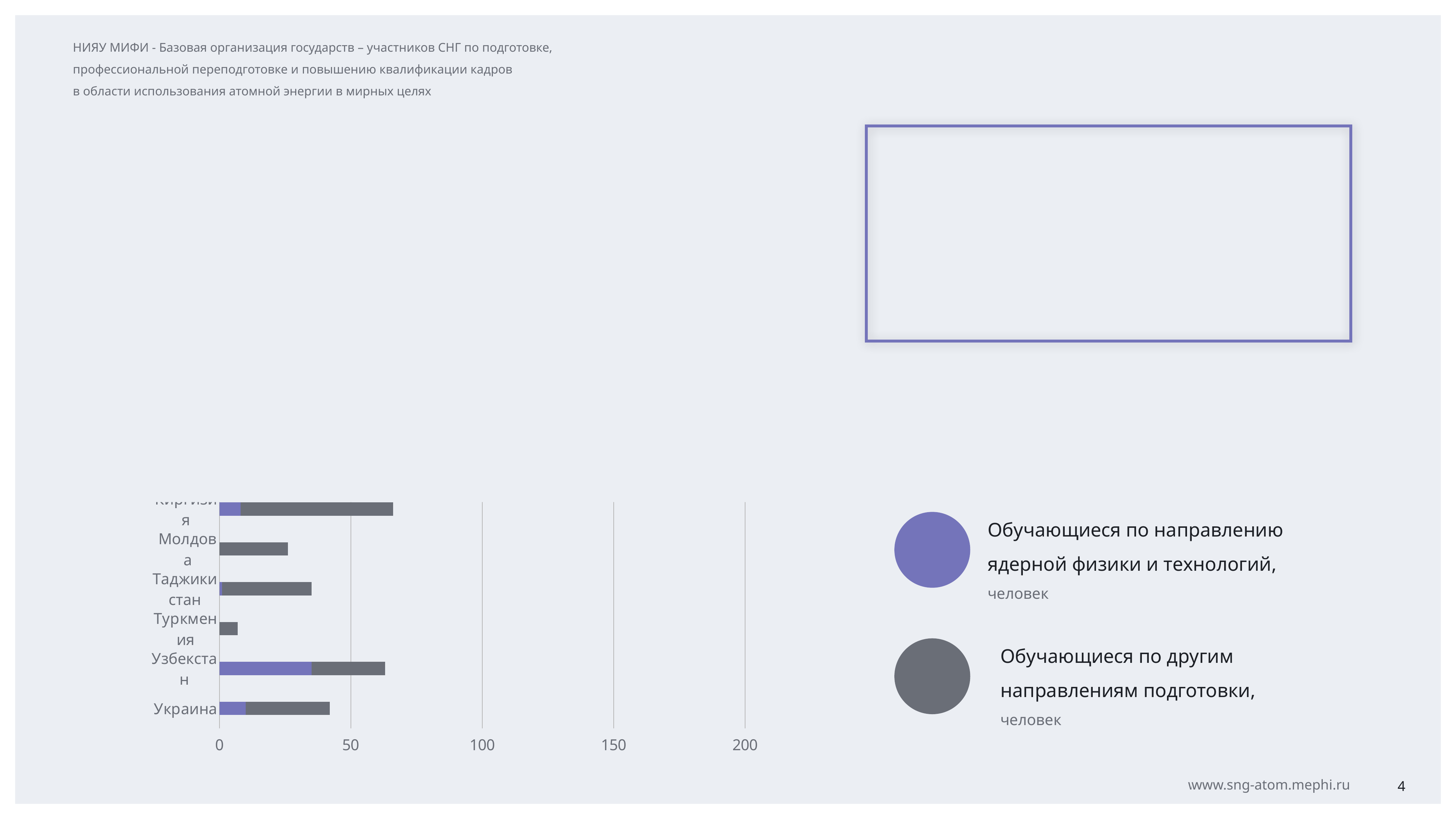
Which has the larger total bar, Узбекистан or Украина? Узбекистан Is the total value for Узбекистан greater or less than 50? greater Is the total value for Украина greater or less than 100? less Which has the larger total bar, Молдова or Таджикистан? Таджикистан How many series does the legend list? 2 Is the total value for Туркмения greater or less than 50? less Which country has the lowest total bar? Туркмения What kind of chart is shown on the slide? bar chart Which colour represents students in other directions of training (Обучающиеся по другим направлениям подготовки)? grey Which country has the largest segment for students in nuclear physics and technology (purple)? Узбекистан How many countries are shown on the chart? 6